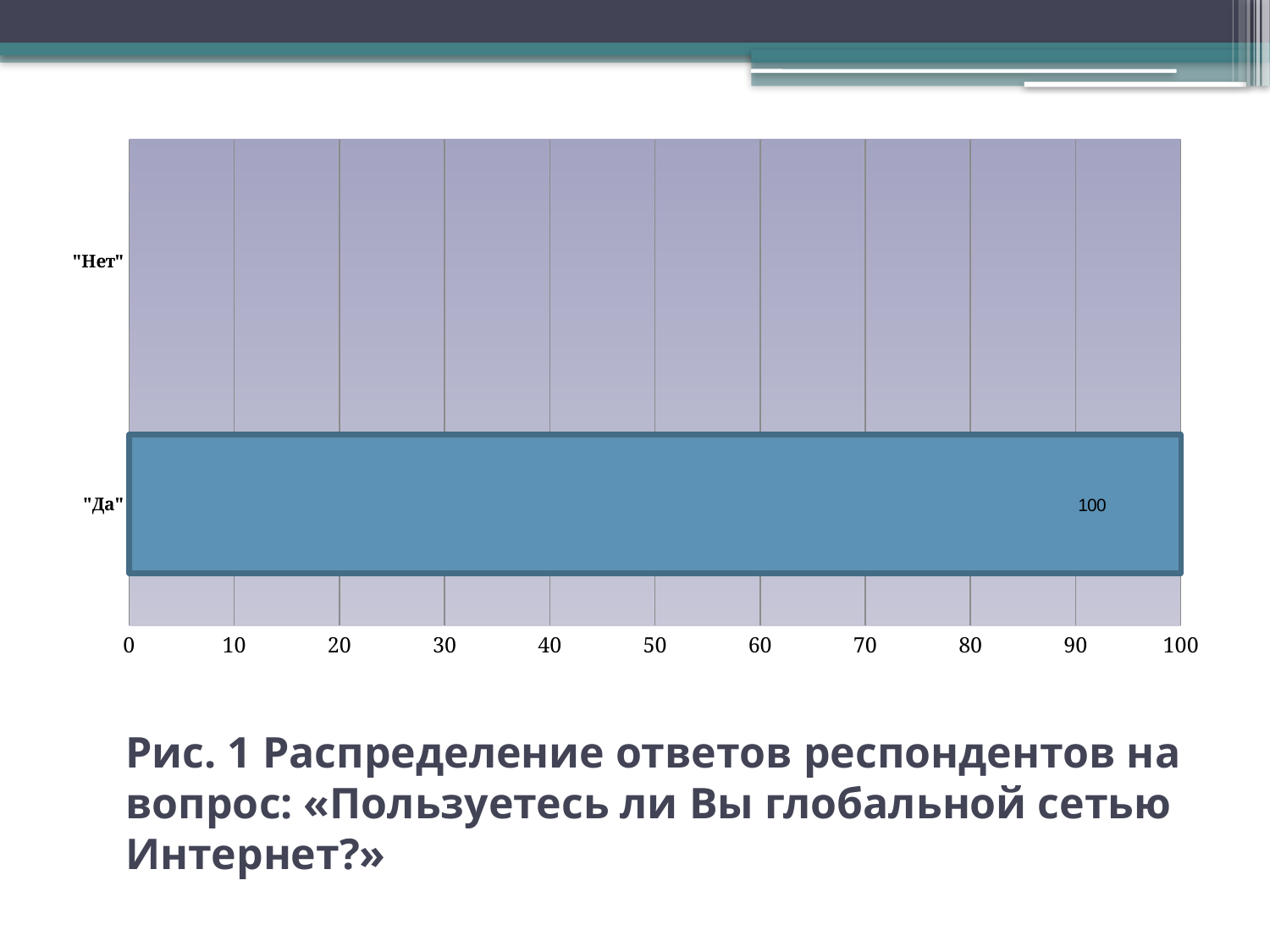
Is the value for "Нет" greater or less than 10? less What figure number is given in the caption below the chart? Рис. 1 What is the value shown for the "Да" category? 100 Which category has the lowest value? "Нет" What kind of chart is shown on the slide? bar chart Is the value for "Да" greater or less than 50? greater How many categories are shown on the chart? 2 Which category has the larger value, "Да" or "Нет"? "Да" Which category has the highest value? "Да" What is the highest value shown on the horizontal axis? 100